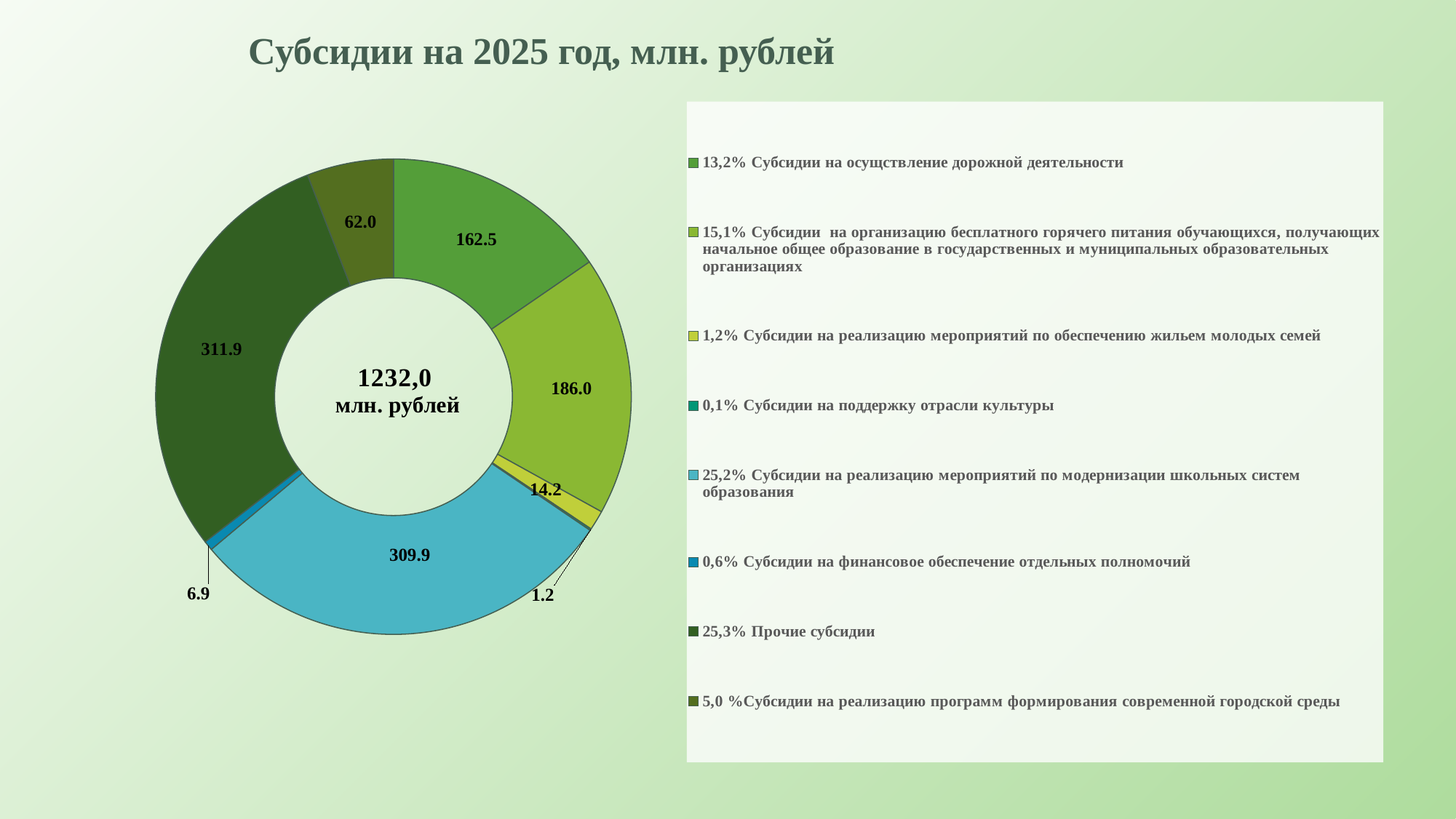
What is the value for Субсидии на реализацию мероприятий по модернизации школьных систем образования? 309.9 Which is larger: the value for Субсидии на реализацию мероприятий по обеспечению жильем молодых семей or Субсидии на финансовое обеспечение отдельных полномочий? Субсидии на реализацию мероприятий по обеспечению жильем молодых семей (14.2) What share of the total do Прочие субсидии represent according to the legend? 25,3% What type of chart is shown on the slide? Doughnut (pie) chart What is the value for Субсидии на осуществление дорожной деятельности? 162.5 What is the title of the chart? Субсидии на 2025 год, млн. рублей How many categories does the chart show? 8 What total is shown in the centre of the doughnut chart? 1232,0 млн. рублей Which category has the smallest value? Субсидии на поддержку отрасли культуры (1.2) What is the value for Субсидии на реализацию программ формирования современной городской среды? 62.0 Which category has the largest value? Прочие субсидии (311.9) What is the difference between the value for Субсидии на организацию бесплатного горячего питания (186.0) and Субсидии на осуществление дорожной деятельности (162.5)? 23.5